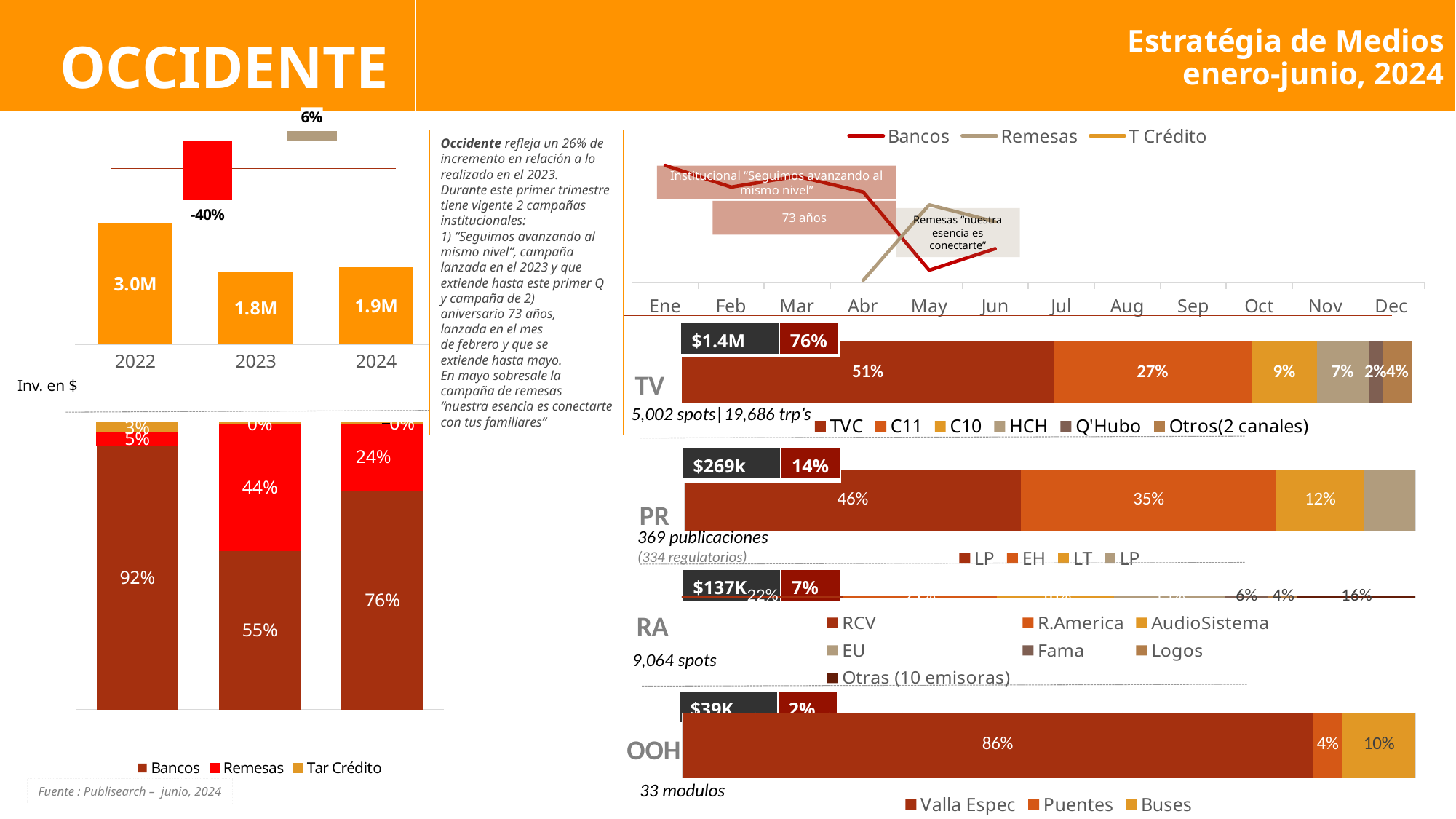
In the 'Inv. en $' bar chart on the left, what percentage change is shown above the 2023 bar? -40% In the 'Inv. en $' bar chart on the left, what is the difference between the 2022 and 2024 values? 1.1M In the TV bar on the right, what is the difference between the C11 and C10 shares? 18% In the line chart at the top right, how many months are shown on the x axis? 12 In the stacked bar chart at the bottom left, what is the Bancos share for 2024? 76% In the 'Inv. en $' bar chart on the left, which year has the lowest investment? 2023 In the 'Inv. en $' bar chart on the left, what is the value for 2022? 3.0M In the PR bar on the right, is the EH share larger or smaller than the LT share? larger In the stacked bar chart at the bottom left, what is the Remesas share for 2023? 44% In the TV bar on the right, what share does TVC have? 51% In the OOH bar on the right, which category has the largest share? Valla Espec How many series does the legend of the stacked bar chart at the bottom left list? 3